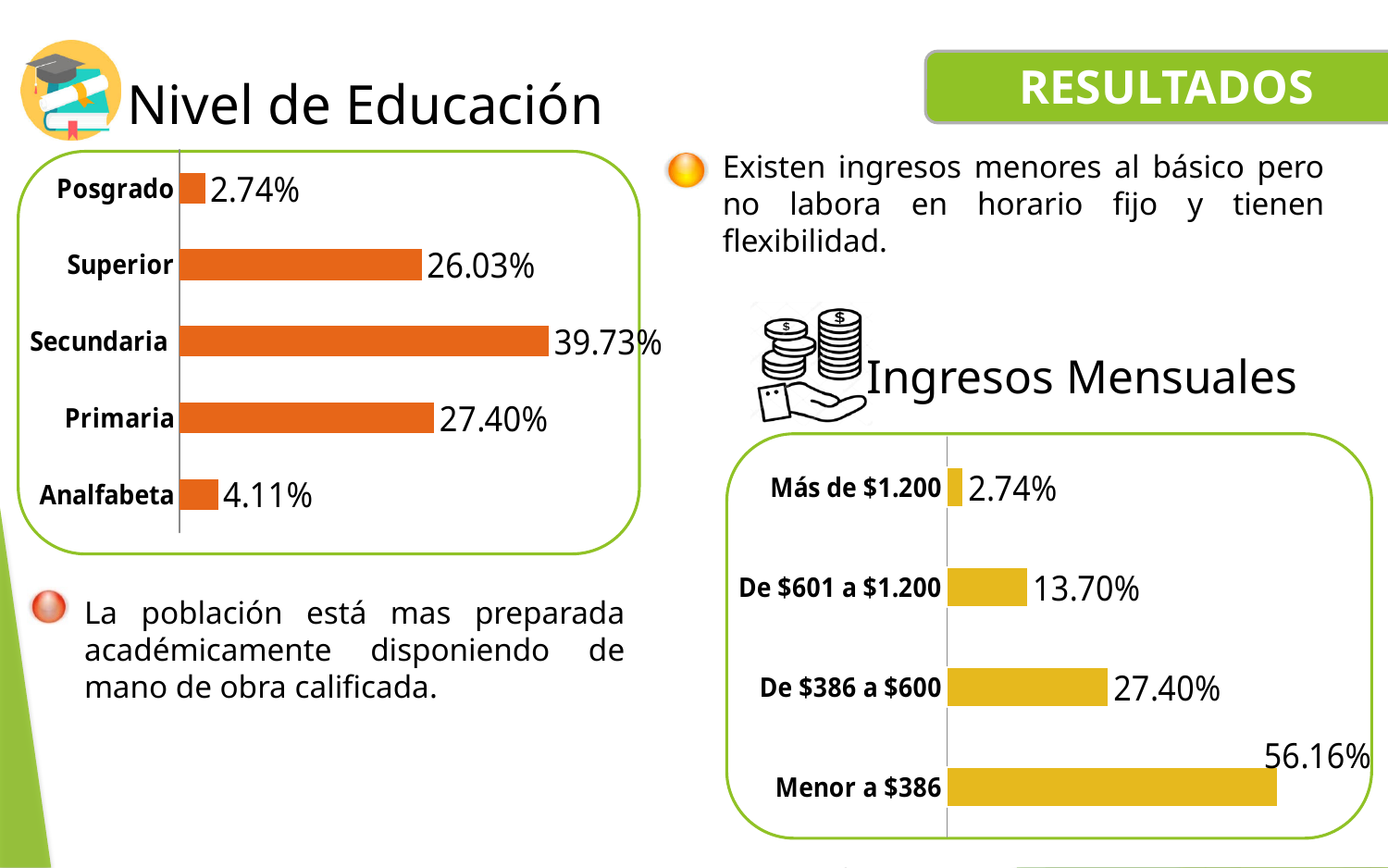
In the Ingresos Mensuales chart, what is the value for De $601 a $1.200? 13.70% In the Ingresos Mensuales chart, which category has the lowest value? Más de $1.200 In the Nivel de Educación chart, which category has the highest value? Secundaria In the Nivel de Educación chart, which category has the lowest value? Posgrado In the Nivel de Educación chart, what is the difference between Primaria and Superior? 1.37% In the Ingresos Mensuales chart, what is the difference between Menor a $386 and De $386 a $600? 28.76% What type of chart is the Ingresos Mensuales chart? Bar chart In the Nivel de Educación chart, what is the value for Analfabeta? 4.11% In the Nivel de Educación chart, what is the value for Secundaria? 39.73% In the Ingresos Mensuales chart, which is larger: De $386 a $600 or De $601 a $1.200? De $386 a $600 In the Ingresos Mensuales chart, which category has the highest value? Menor a $386 In the Nivel de Educación chart, how many categories are shown? 5